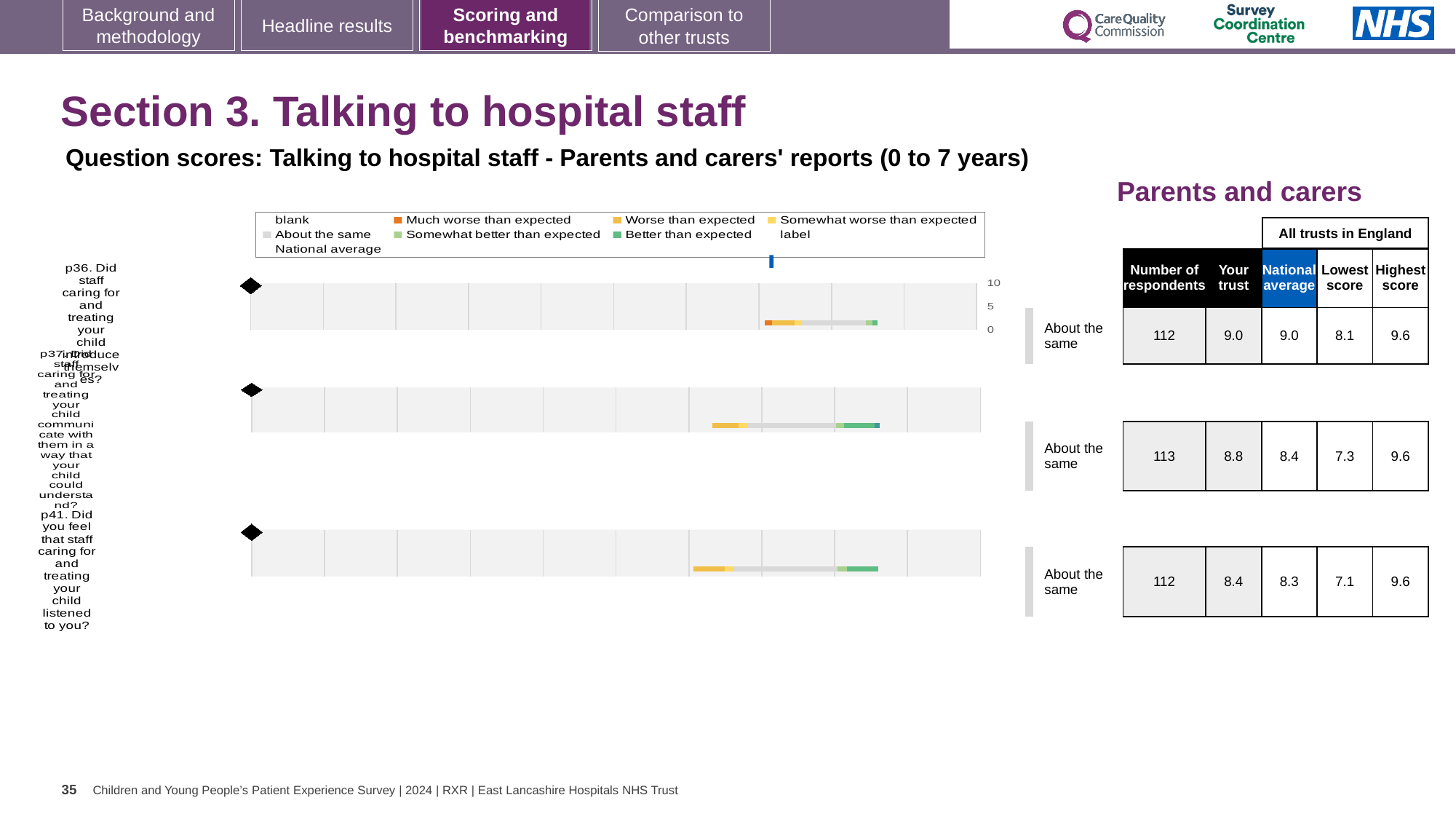
What kind of chart is used to show the question scores on this slide? Bar chart What colour does the legend use for 'Much worse than expected'? Orange How many respondents answered p37? 113 By how much does the trust's score for p37 exceed the national average for p37? 0.4 What benchmark category is shown for all three questions in the chart? About the same What is the highest score among all trusts in England for p36? 9.6 Which question has the highest 'Your trust' score? p36 What is the 'Your trust' score for p37 (Did staff communicate with them in a way that your child could understand)? 8.8 Which has the larger 'Your trust' score, p36 or p41? p36 What is the national average score for p41 (Did you feel that staff caring for and treating your child listened to you)? 8.3 Which question has the lowest 'Lowest score' across all trusts in England? p41 How many questions (categories) are plotted in the chart? 3